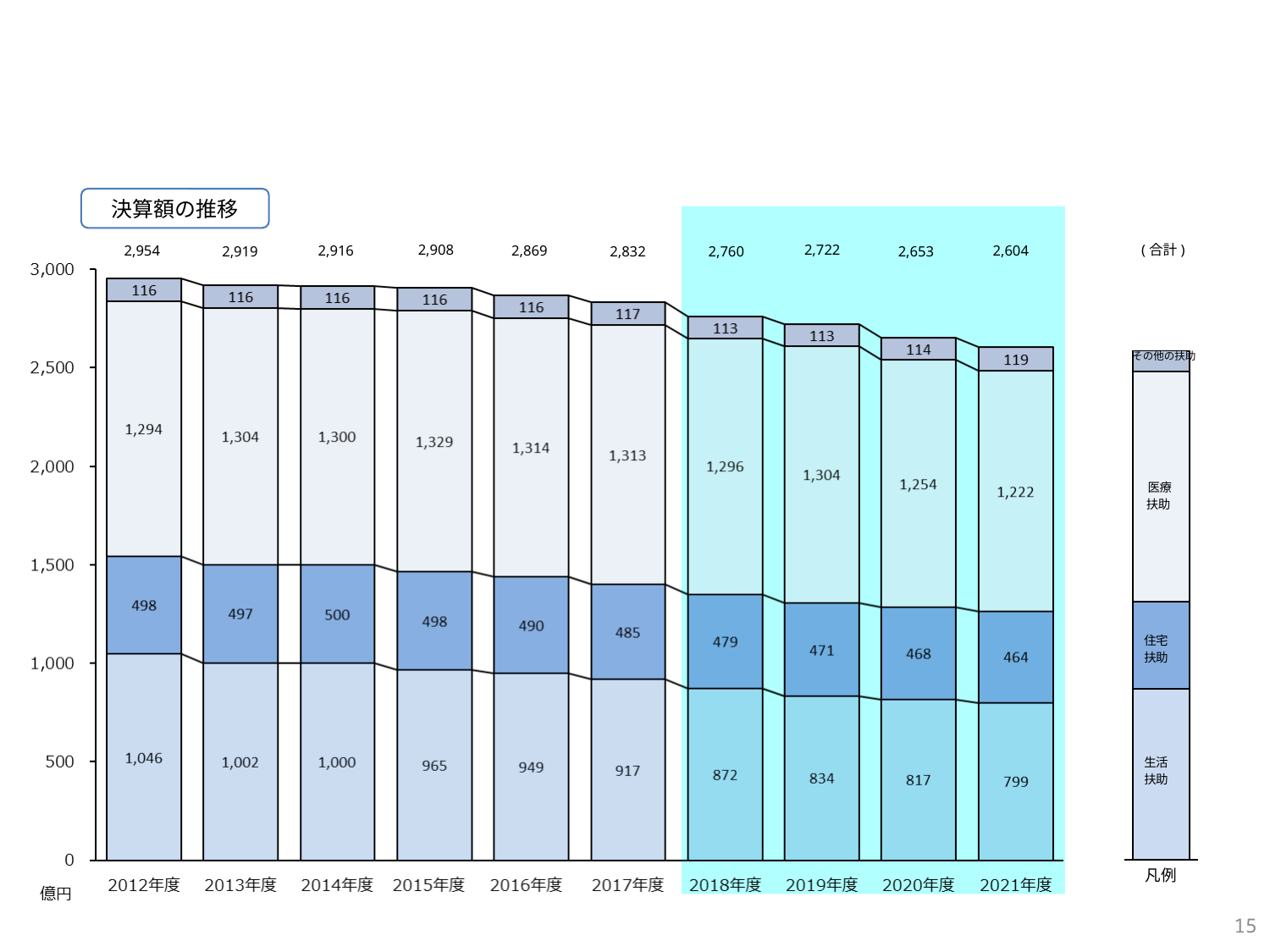
Do the totals rise or fall from 2012年度 to 2021年度? Fall What is the value of 生活扶助 for 2021年度? 799 What is the difference between the totals for 2012年度 and 2021年度? 350 Which is larger, 生活扶助 in 2013年度 or 生活扶助 in 2019年度? 2013年度 How many segments (series) does the legend (凡例) list? 4 What kind of chart is shown on the slide? Stacked bar chart What is the value of 医療扶助 for 2015年度? 1,329 How many fiscal years are shown on the x axis? 10 Which year has the highest total (合計)? 2012年度 What is the value of 住宅扶助 for 2018年度? 479 What is the total (合計) shown above the bar for 2012年度? 2,954 Which year has the lowest total (合計)? 2021年度